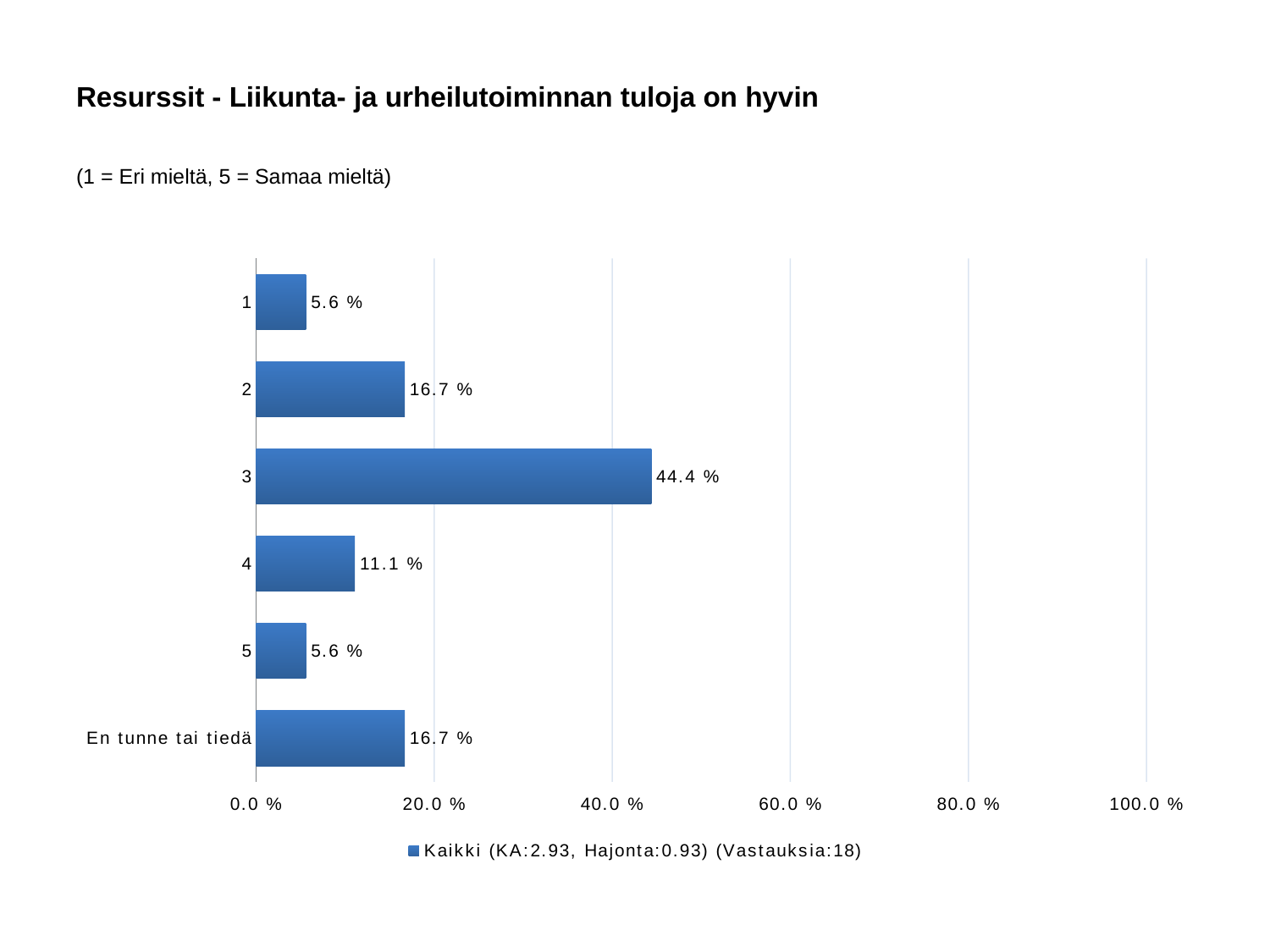
What is the value for category 4? 11.1 % What is the value for 'En tunne tai tiedä'? 16.7 % Is the value for category 3 greater or less than 40.0 %? greater Which category has the highest value? 3 What kind of chart is shown on the slide? bar chart How many categories are shown on the chart? 6 What is the difference between the values for category 3 and category 4? 33.3 % What is the title of the chart? Resurssit - Liikunta- ja urheilutoiminnan tuloja on hyvin What is the value for category 2? 16.7 % How many series does the legend list? 1 Which is larger, the value for category 2 or the value for category 4? 2 What is the value for category 3? 44.4 %